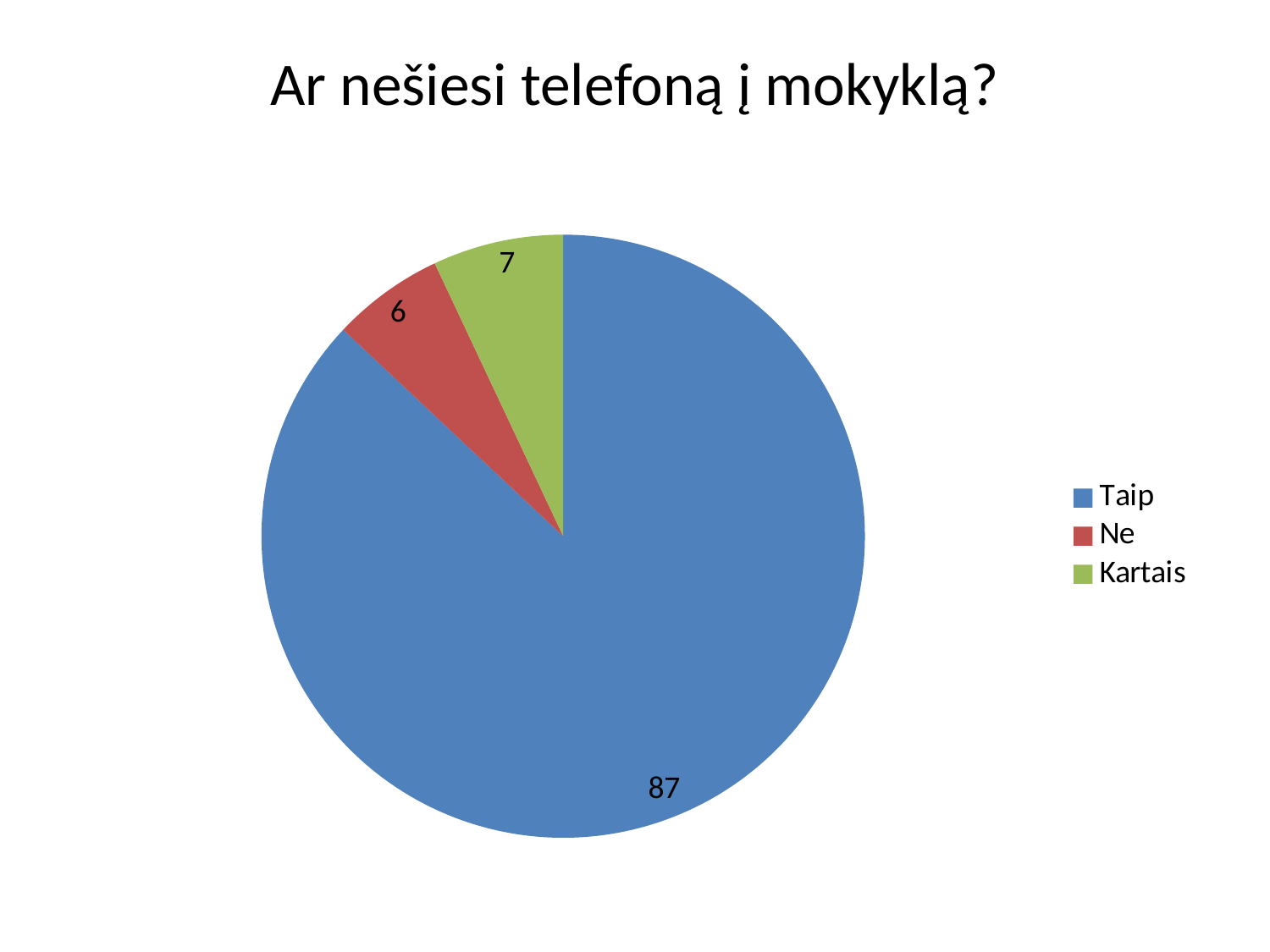
What is the value for Ne? 6 Which category has the largest slice? Taip Which category has the smallest slice? Ne What is the value for Kartais? 7 Which is larger, the value for Ne or the value for Kartais? Kartais What share of the pie does Taip represent? 87% What is the title of the chart? Ar nešiesi telefoną į mokyklą? What is the difference between the values for Taip and Kartais? 80 How many categories does the pie chart have? 3 What kind of chart is shown on the slide? pie chart What colour is the slice for Ne? red What is the value for Taip? 87